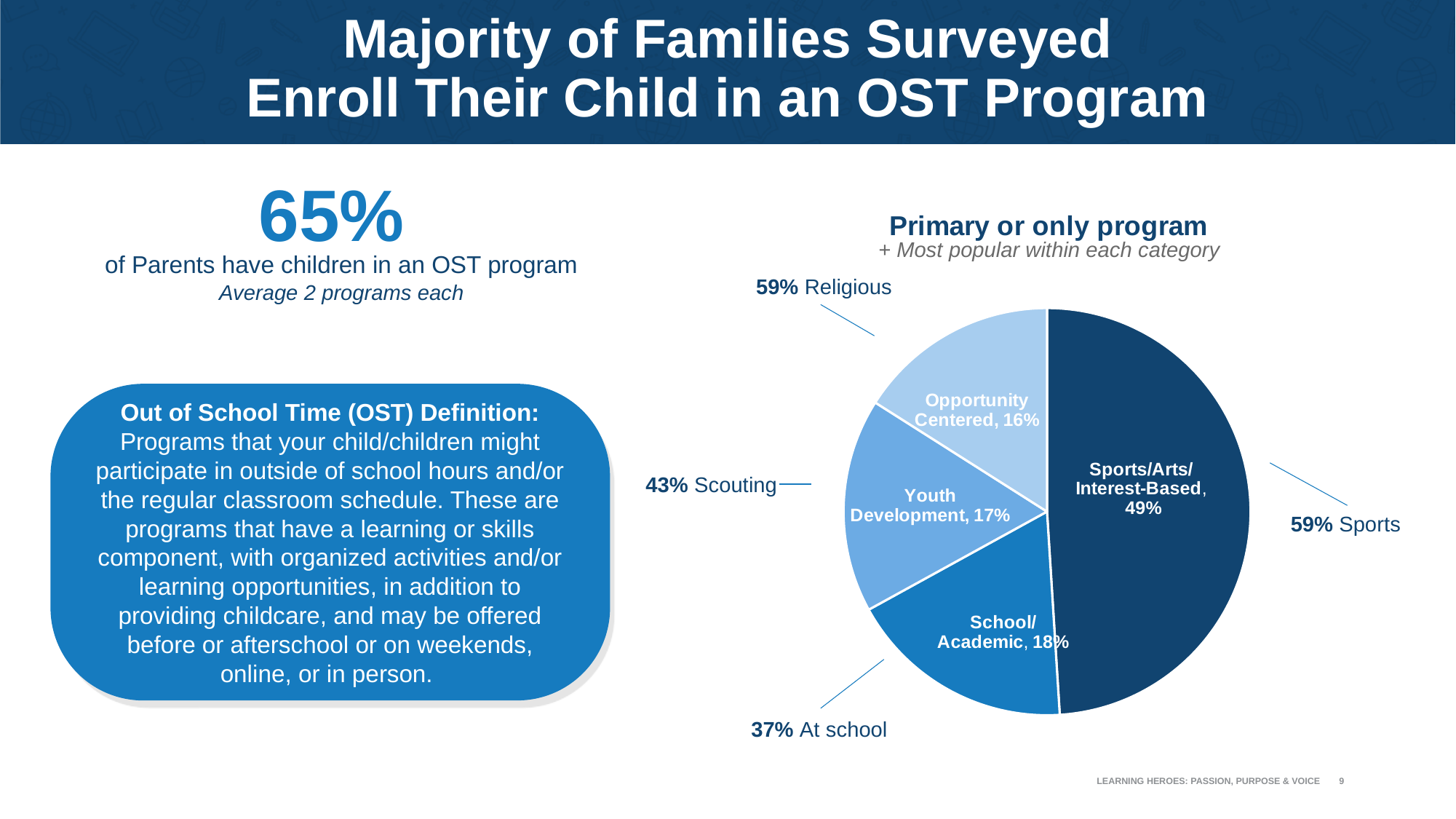
What is the difference in percentage points between the Sports/Arts/Interest-Based slice and the School/Academic slice? 31 Which is larger, the Youth Development slice or the Opportunity Centered slice? Youth Development According to the annotation on the pie chart, what percentage is the most popular program within the Sports/Arts/Interest-Based category (Sports)? 59% What kind of chart is shown on the slide? Pie chart Which slice of the pie chart is the largest? Sports/Arts/Interest-Based What share of the pie does Sports/Arts/Interest-Based have? 49% How many slices does the pie chart have? 4 Which slice of the pie chart is the smallest? Opportunity Centered What is the title of the pie chart? Primary or only program What share of the pie does Opportunity Centered have? 16% What share of the pie does Youth Development have? 17% What share of the pie does School/Academic have? 18%